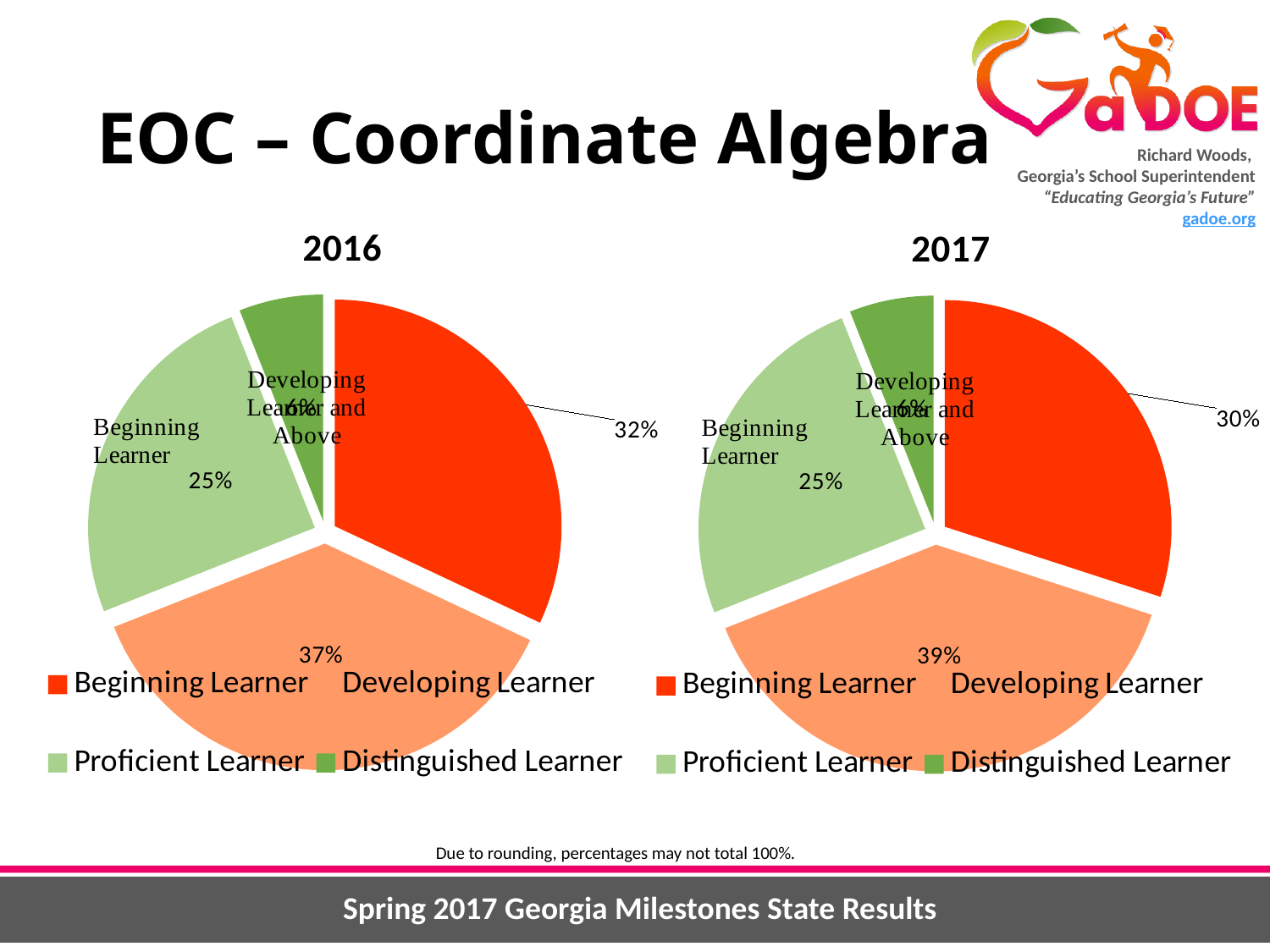
In the 2017 pie chart, what percentage is shown for Proficient Learner? 25% In the 2017 pie chart, which category has the smallest share? Distinguished Learner In the 2016 pie chart, what percentage is shown for Beginning Learner? 32% How many categories does the legend of the 2016 chart list? 4 Is the Beginning Learner share larger in the 2016 chart or the 2017 chart? 2016 In the 2017 pie chart, what percentage is shown for Beginning Learner? 30% In the 2016 pie chart, which category has the largest share? Developing Learner What type of chart is used for the 2017 results? Pie chart What is the difference between the Developing Learner percentage in 2017 and in 2016? 2% In the 2016 pie chart, what percentage is shown for Developing Learner? 37% What colour represents Beginning Learner in the legends? Red In the 2017 pie chart, what percentage is shown for Developing Learner? 39%